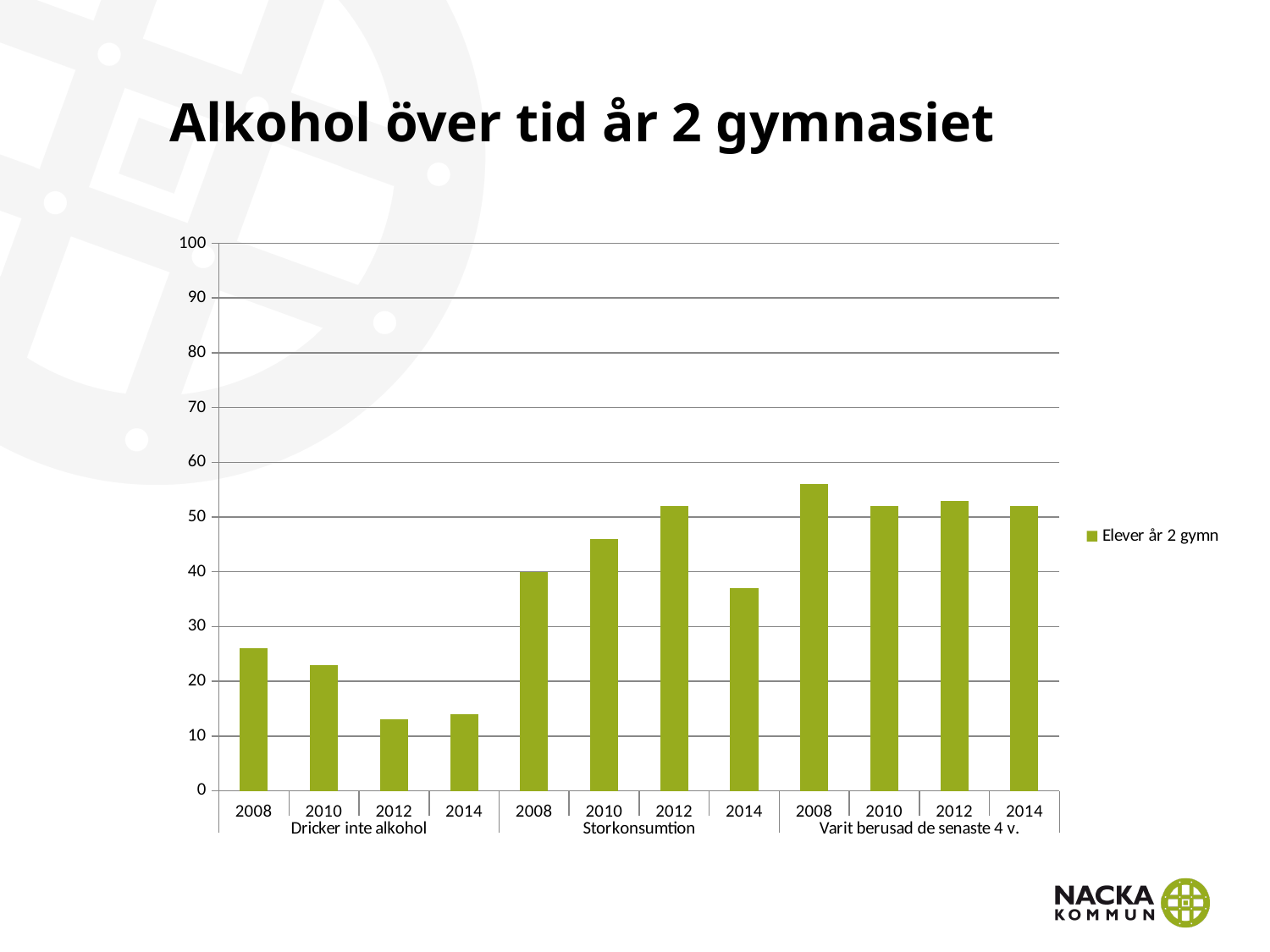
How many series does the legend list? 1 What kind of chart is shown on the slide? Bar chart Is the value for Dricker inte alkohol in 2012 greater or less than 20? less Is the value for Varit berusad de senaste 4 v. in 2008 greater or less than 50? greater Is the value for Storkonsumtion in 2010 greater or less than 40? greater How many category groups are shown along the x axis? 3 How many bars are plotted in the chart? 12 Within the Dricker inte alkohol group, which year has the highest bar? 2008 What is the legend entry for the series? Elever år 2 gymn Which is larger: Storkonsumtion in 2012 or Storkonsumtion in 2014? Storkonsumtion in 2012 Which bar is the highest in the whole chart? Varit berusad de senaste 4 v., 2008 Within the Storkonsumtion group, which year has the lowest bar? 2014